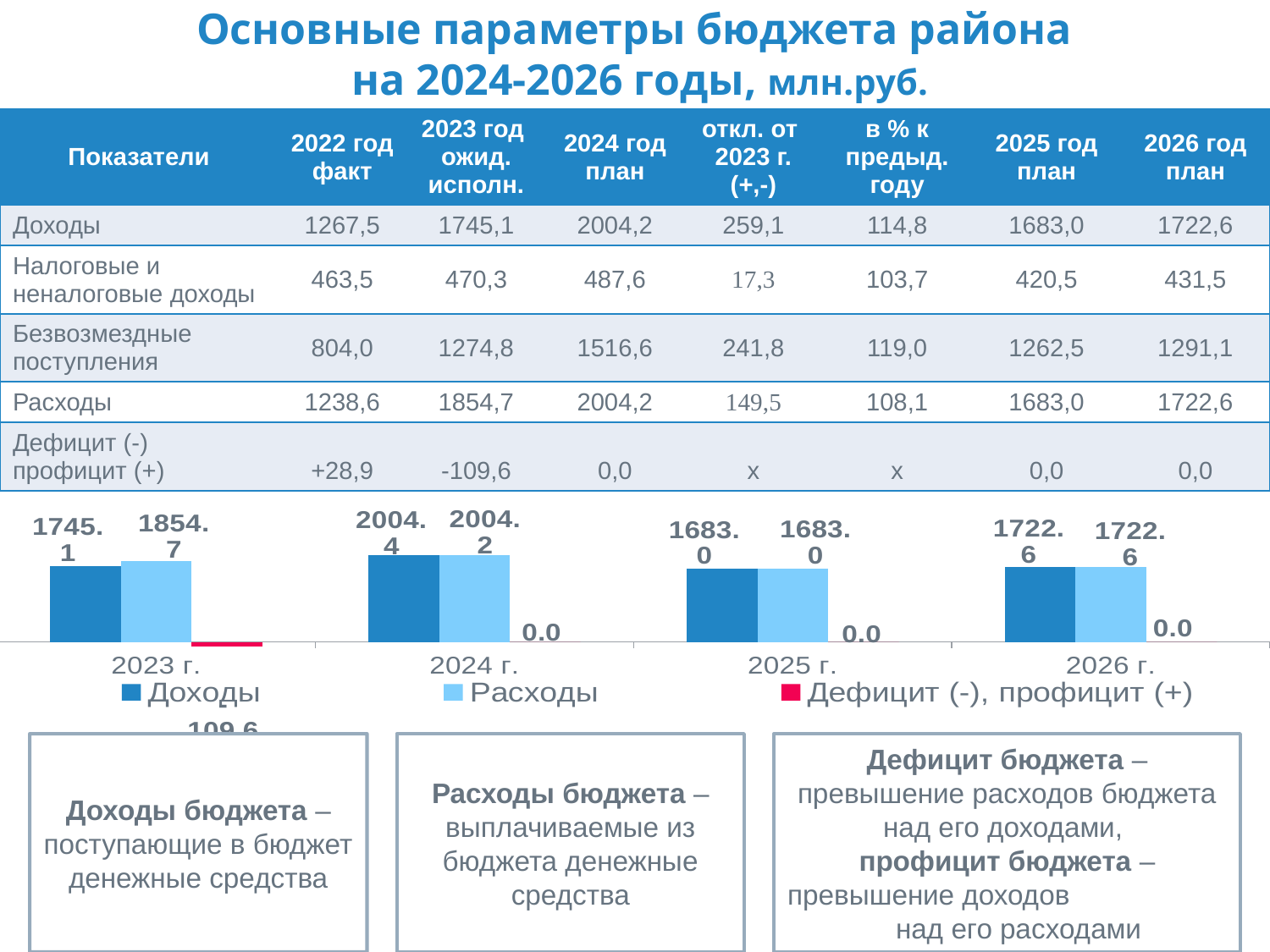
How many series does the chart legend list? 3 In the chart, which colour represents the series Дефицит (-), профицит (+)? red In the chart, what is the value of Расходы for 2025 г.? 1683.0 In the chart, which year has the highest value of Доходы? 2024 г. In the chart, what is the value of Расходы for 2023 г.? 1854.7 In the chart, what is the value of Доходы for 2023 г.? 1745.1 What type of chart is shown below the table? bar chart In the chart, what is the difference between Расходы and Доходы for 2023 г.? 109.6 How many year categories are shown on the x axis of the chart? 4 In the chart, what is the value of Дефицит (-), профицит (+) for 2026 г.? 0.0 In the chart, which is larger for 2023 г.: Доходы or Расходы? Расходы In the chart, what is the value of Доходы for 2024 г.? 2004.4